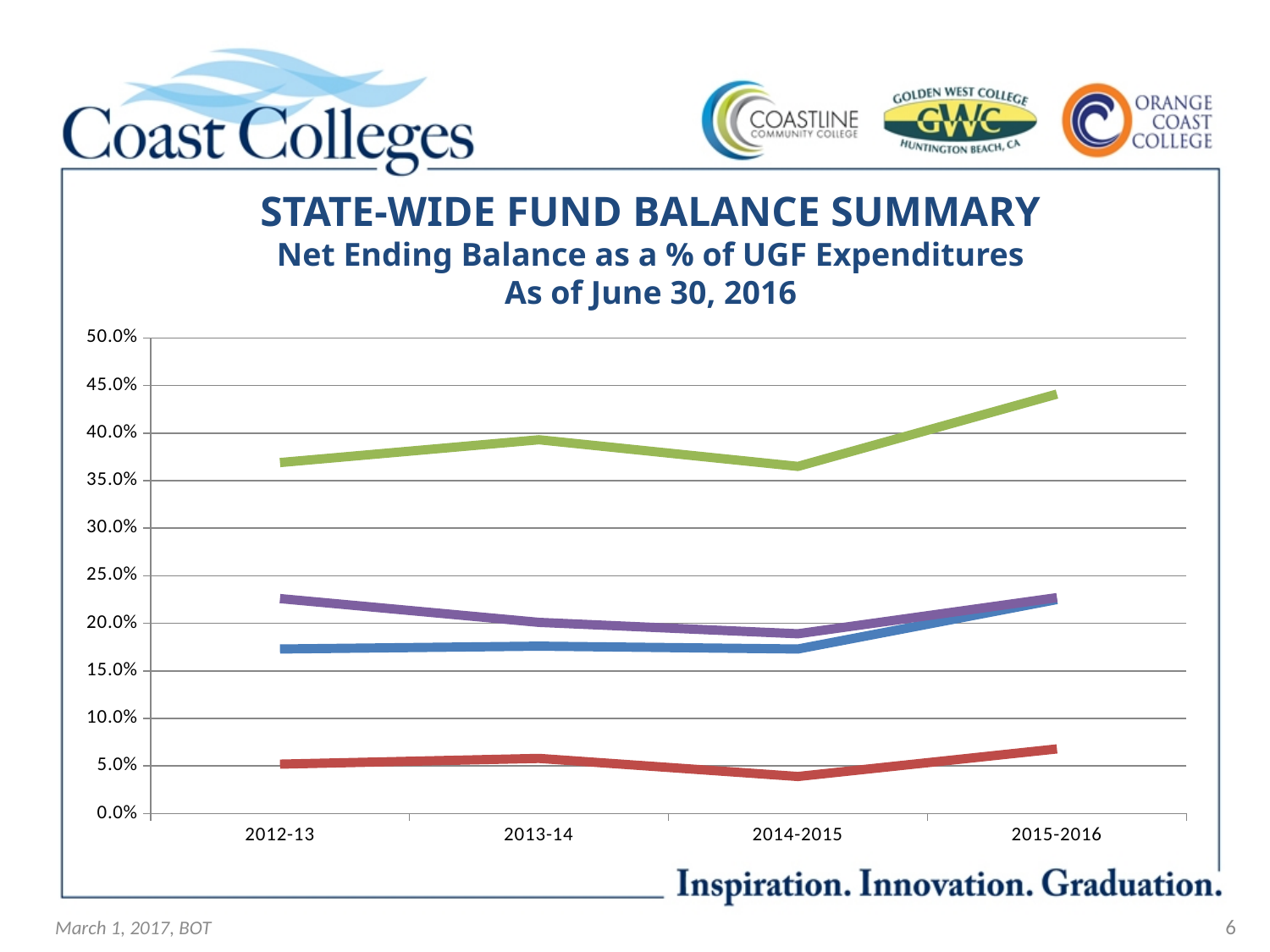
In which year does the green line reach its highest value? 2015-2016 In which year does the red line reach its lowest value? 2014-2015 Is the value of the red line for 2014-2015 greater or less than 5.0%? less Does the green line rise or fall from 2014-2015 to 2015-2016? Rise Is the value of the blue line for 2012-13 greater or less than 20.0%? less Which line is the highest across all years? The green line How many lines are plotted on the chart? 4 What kind of chart is shown on the slide? Line chart How many fiscal-year categories are shown on the x axis? 4 Is the value of the purple line for 2012-13 greater or less than 20.0%? greater What is the title of the chart? STATE-WIDE FUND BALANCE SUMMARY